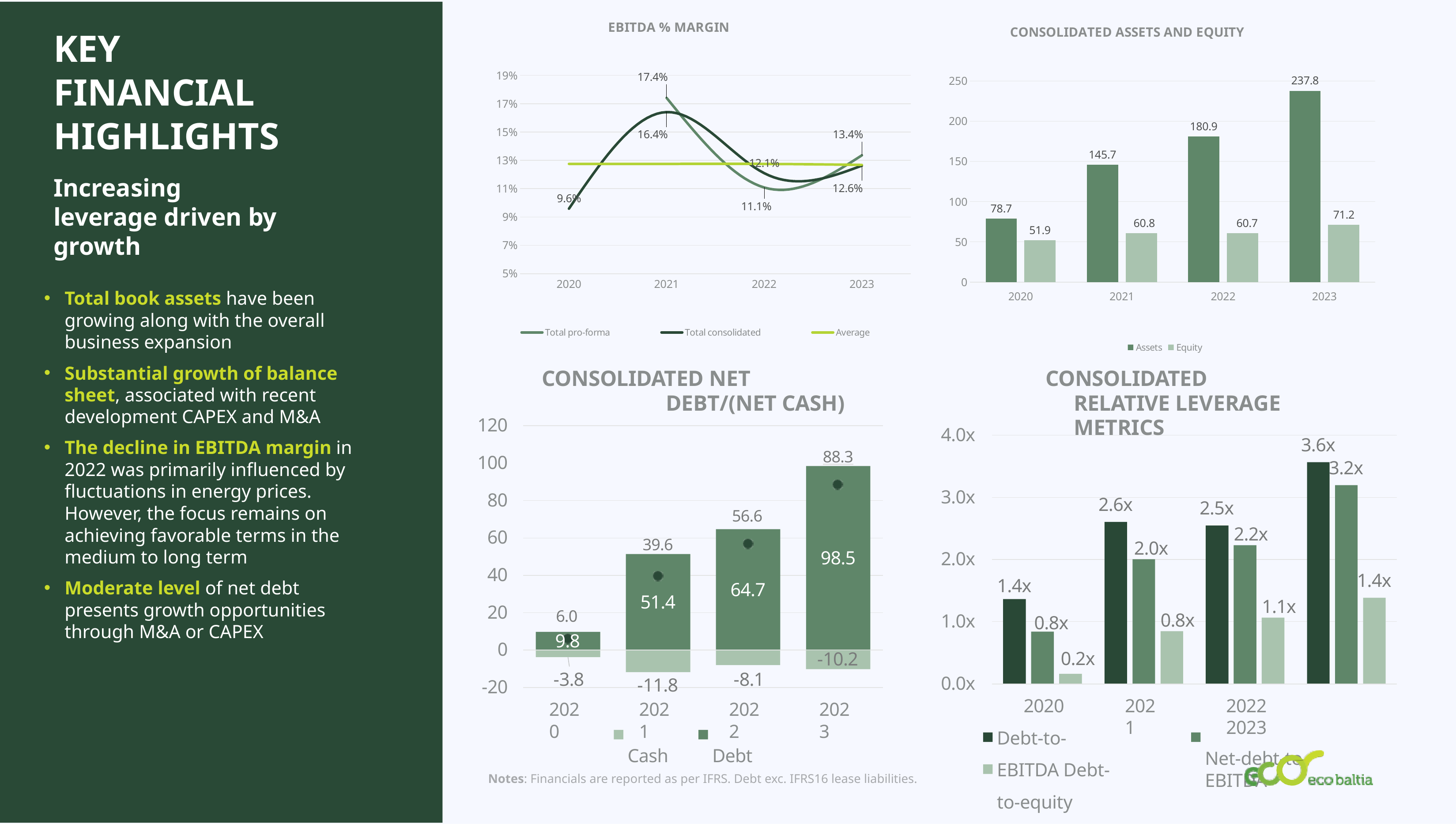
In the CONSOLIDATED ASSETS AND EQUITY chart, which year has the lowest Equity value? 2020 In the CONSOLIDATED ASSETS AND EQUITY chart, what is the value of Equity in 2021? 60.8 In the CONSOLIDATED NET DEBT/(NET CASH) chart, what is the Cash value for 2021? -11.8 In the CONSOLIDATED ASSETS AND EQUITY chart, what is the value of Assets in 2023? 237.8 In the CONSOLIDATED NET DEBT/(NET CASH) chart, what net value is labelled for 2022? 56.6 In the CONSOLIDATED RELATIVE LEVERAGE METRICS chart, what is the Debt-to-EBITDA value for 2023? 3.6x How many series does the legend of the EBITDA % MARGIN chart list? 3 In the CONSOLIDATED NET DEBT/(NET CASH) chart, what is the Debt value for 2023? 98.5 In the EBITDA % MARGIN chart, what is the highest labelled margin value? 17.4% In the CONSOLIDATED RELATIVE LEVERAGE METRICS chart, which year has the lowest Net-debt-to-EBITDA value? 2020 In the CONSOLIDATED ASSETS AND EQUITY chart, by how much did Assets grow from 2020 to 2023? 159.1 In the CONSOLIDATED RELATIVE LEVERAGE METRICS chart, is Debt-to-equity in 2022 larger or smaller than Debt-to-equity in 2021? larger